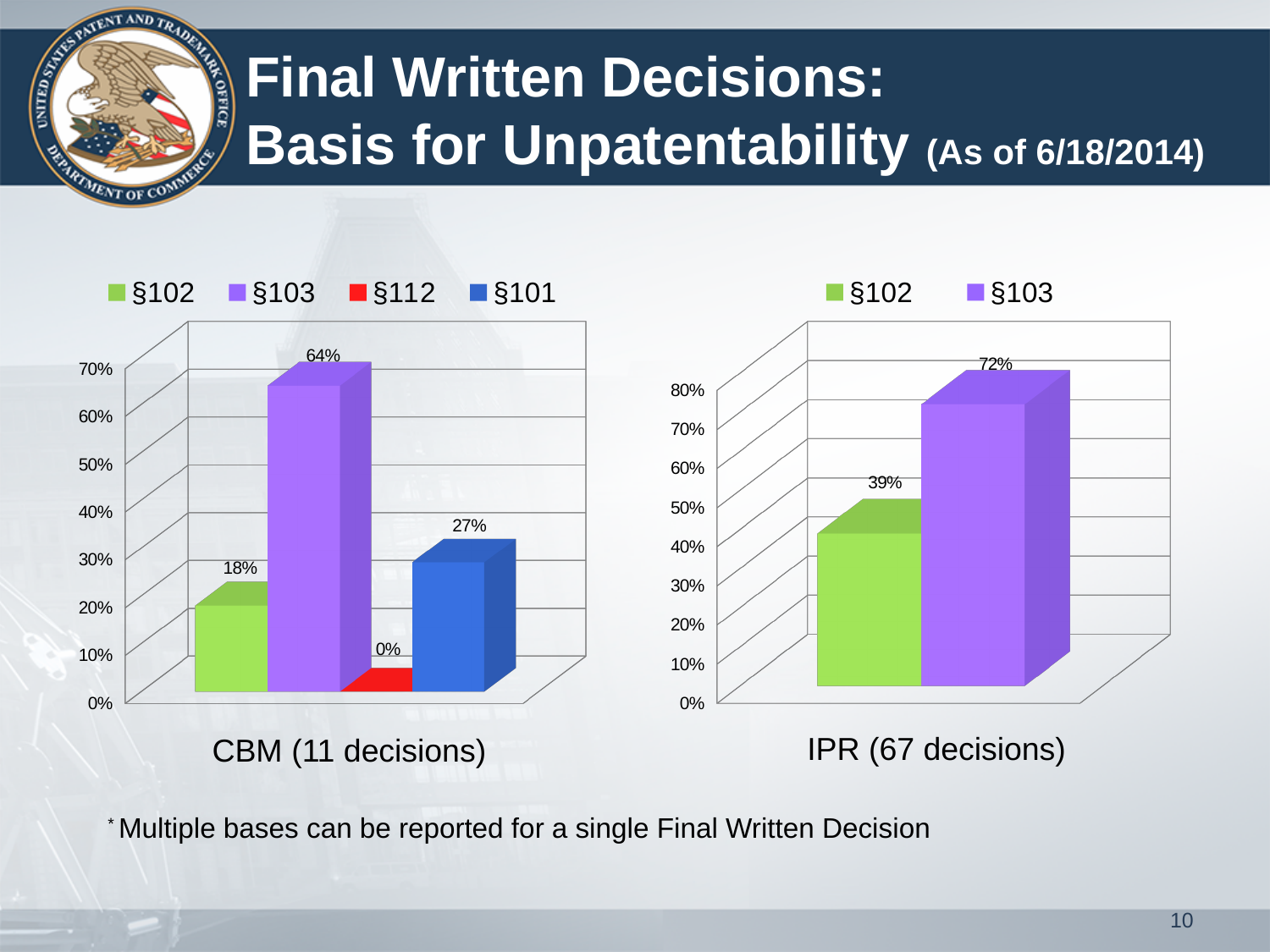
In the IPR (67 decisions) chart, what is the difference between the §103 and §102 values? 33% In the CBM (11 decisions) chart, which basis has the highest value? §103 In the IPR (67 decisions) chart, what is the value for §103? 72% In the CBM (11 decisions) chart, which basis has the lowest value? §112 In the CBM (11 decisions) chart, what is the value for §101? 27% In the CBM (11 decisions) chart, what is the value for §112? 0% In the CBM (11 decisions) chart, what is the difference between the §101 and §102 values? 9% What kind of chart is the IPR (67 decisions) chart? Bar chart In the IPR (67 decisions) chart, what is the value for §102? 39% In the CBM (11 decisions) chart, which is larger, the value for §102 or the value for §101? §101 How many series does the legend of the CBM (11 decisions) chart list? 4 In the CBM (11 decisions) chart, what is the value for §103? 64%